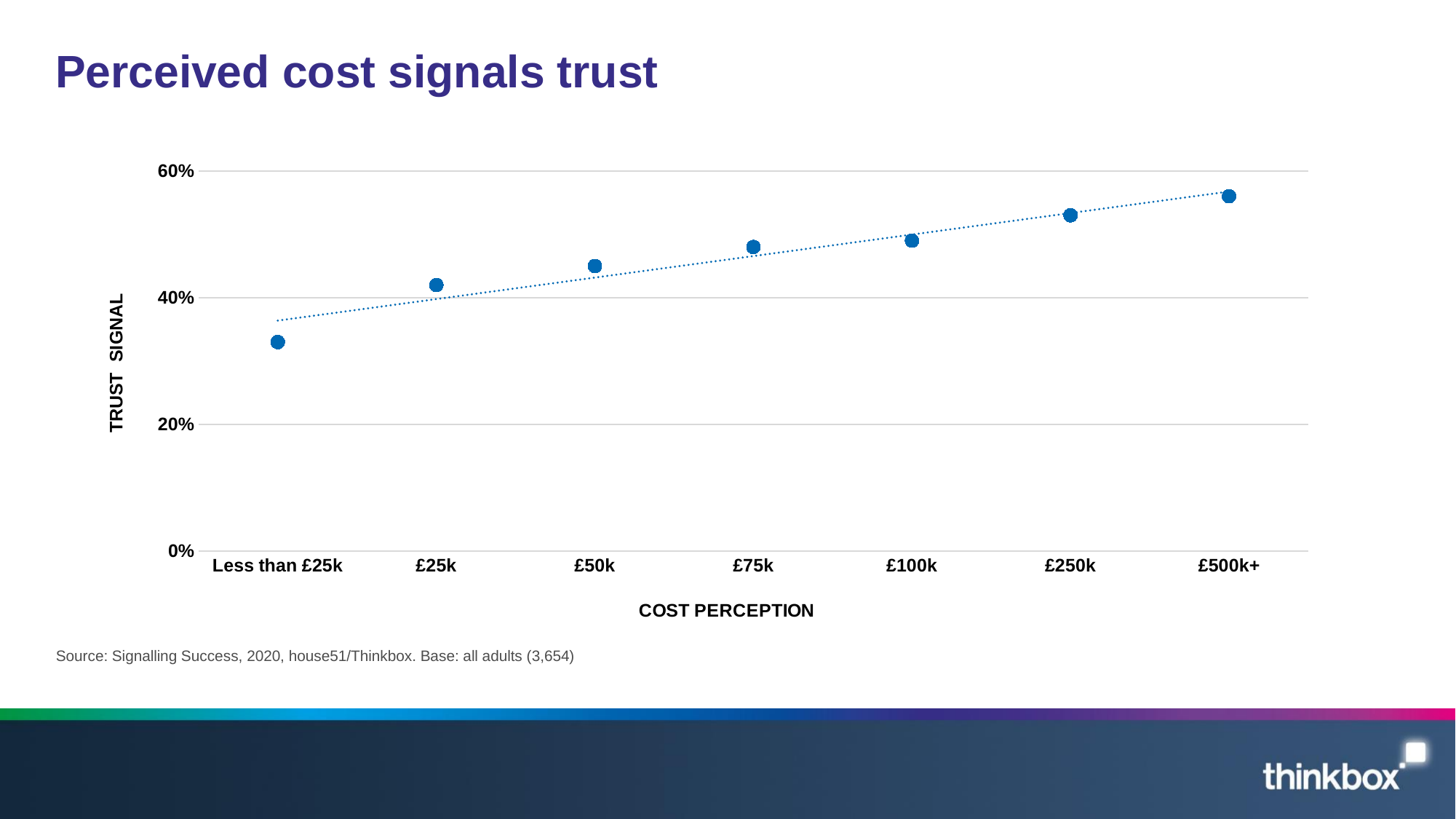
Is the trust signal for £25k greater or less than 40%? greater Which cost perception category has the lowest trust signal? Less than £25k What is the label of the y axis? TRUST SIGNAL Is the trust signal for £250k greater or less than 40%? greater What kind of chart is shown on the slide? Scatter chart Which has a higher trust signal, £50k or £250k? £250k Is the trust signal for Less than £25k greater or less than 40%? less Do the trust signal values rise or fall as cost perception increases along the x axis? Rise How many cost perception categories are plotted on the x axis? 7 What is the title of the slide? Perceived cost signals trust Which cost perception category has the highest trust signal? £500k+